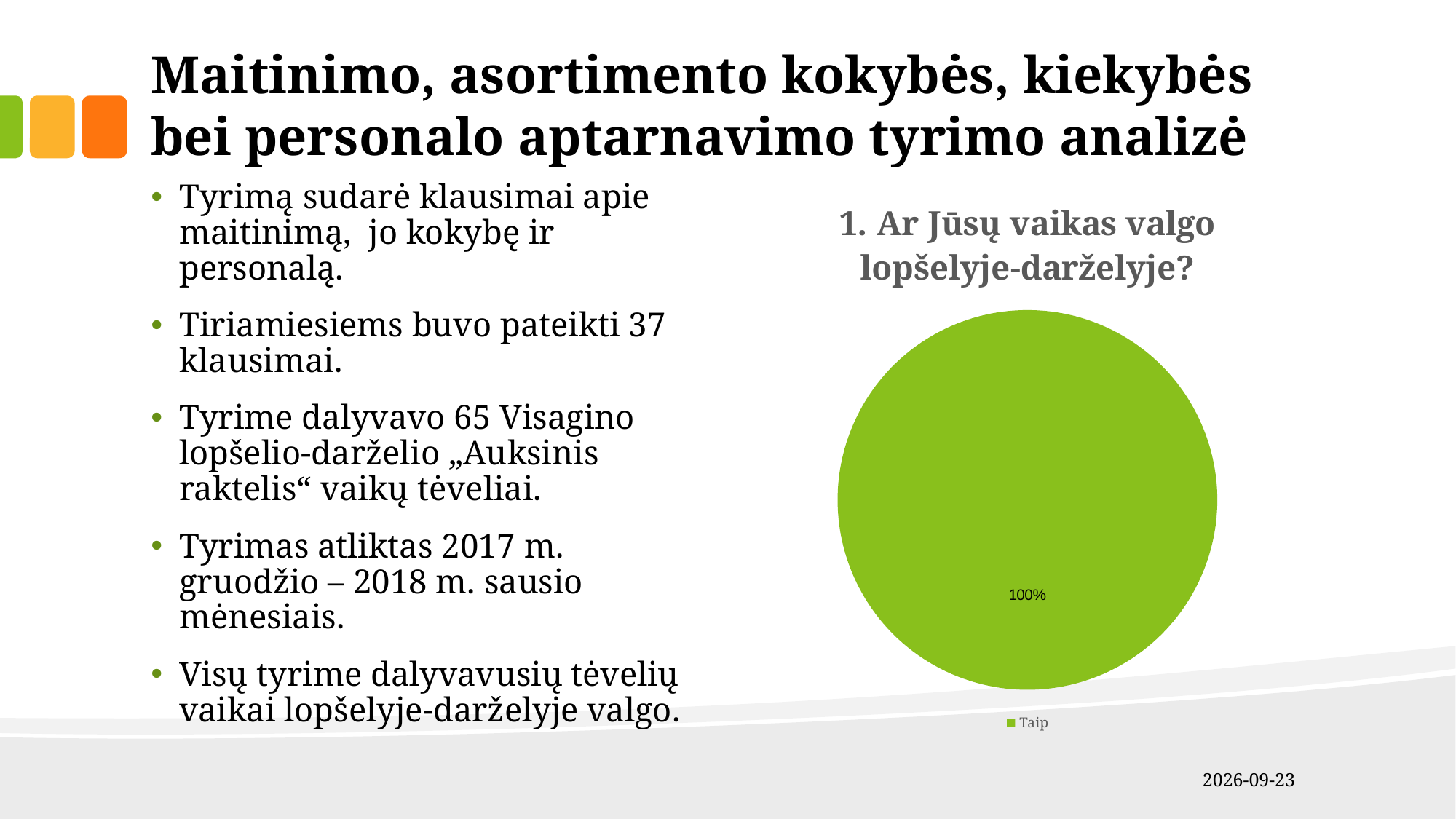
Which category has the largest share of the pie? Taip What is the legend entry for the pie chart? Taip How many slices does the pie chart have? 1 What kind of chart is shown on the slide? pie chart What is the title of the chart? 1. Ar Jūsų vaikas valgo lopšelyje-darželyje? What value is printed on the pie slice? 100% How many entries does the chart legend list? 1 What share of the pie does the "Taip" slice take? 100%